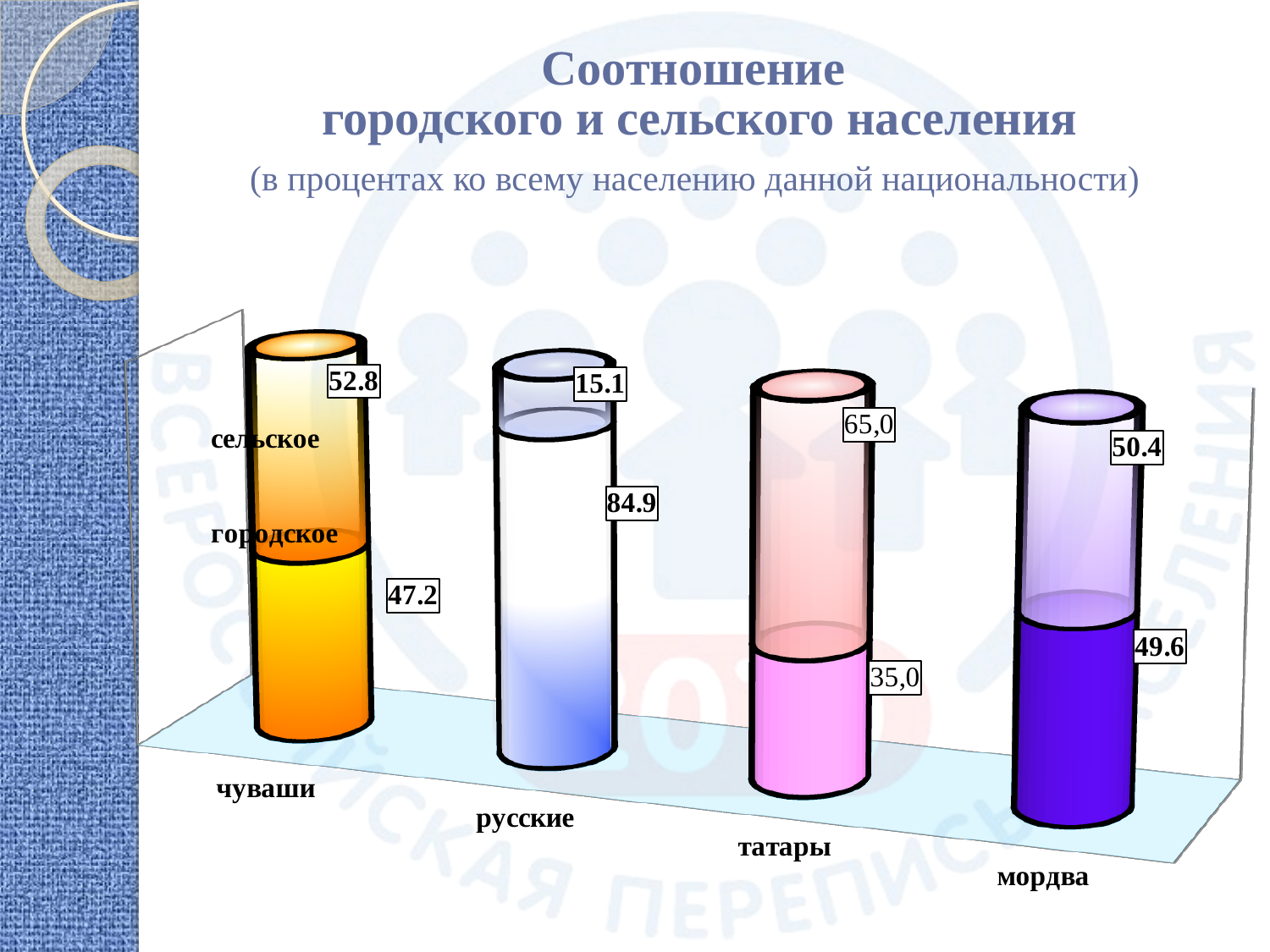
What kind of chart is shown on the slide? stacked bar chart What is the total of the stacked bar for мордва? 100 Which nationality has the lowest value for сельское? русские How many series does each bar consist of? 2 Which is larger for чуваши: сельское or городское? сельское Which nationality has the highest value for городское? русские What is the value for сельское for татары? 65,0 What is the difference between the городское values for русские and татары? 49.9 What is the value for городское for русские? 84.9 What is the value for городское for мордва? 49.6 What is the value for сельское for чуваши? 52.8 How many nationalities are shown on the chart? 4